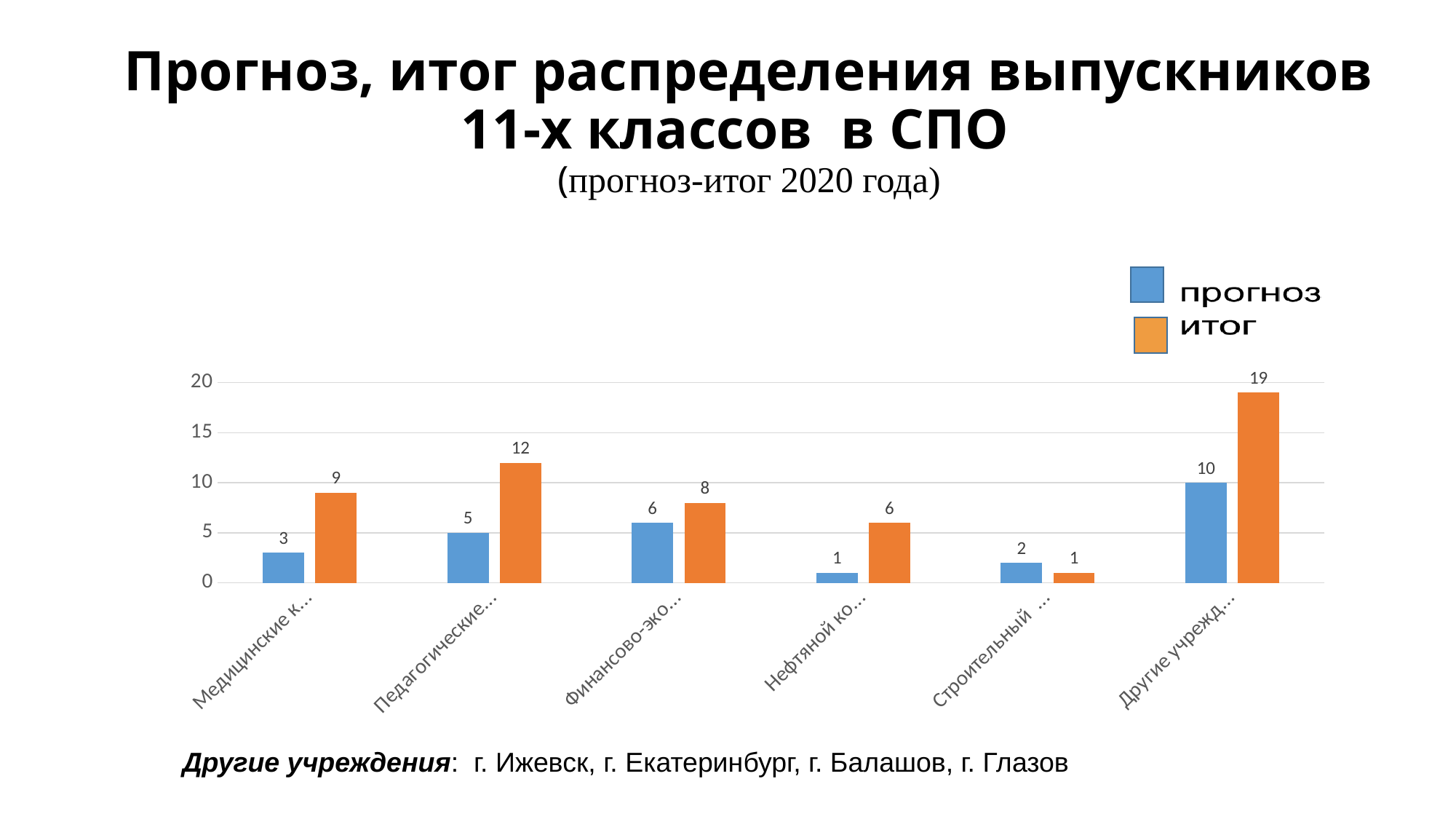
Which colour represents the 'итог' series in the legend? orange What kind of chart is shown on the slide? bar chart What is the 'итог' value for the category labelled 'Медицинские к...'? 9 How many categories are shown on the x axis? 6 Is the 'итог' value for the category labelled 'Педагогические...' greater or less than 10? greater What is the difference between the 'итог' and 'прогноз' values for the category labelled 'Другие учрежд...'? 9 For the category labelled 'Строительный ...', which is larger: 'прогноз' or 'итог'? прогноз What is the 'прогноз' value for the category labelled 'Педагогические...'? 5 What is the 'итог' value for the category labelled 'Нефтяной ко...'? 6 Which category has the lowest 'прогноз' value? Нефтяной ко... How many series does the legend list? 2 Which category has the highest 'итог' value? Другие учрежд...